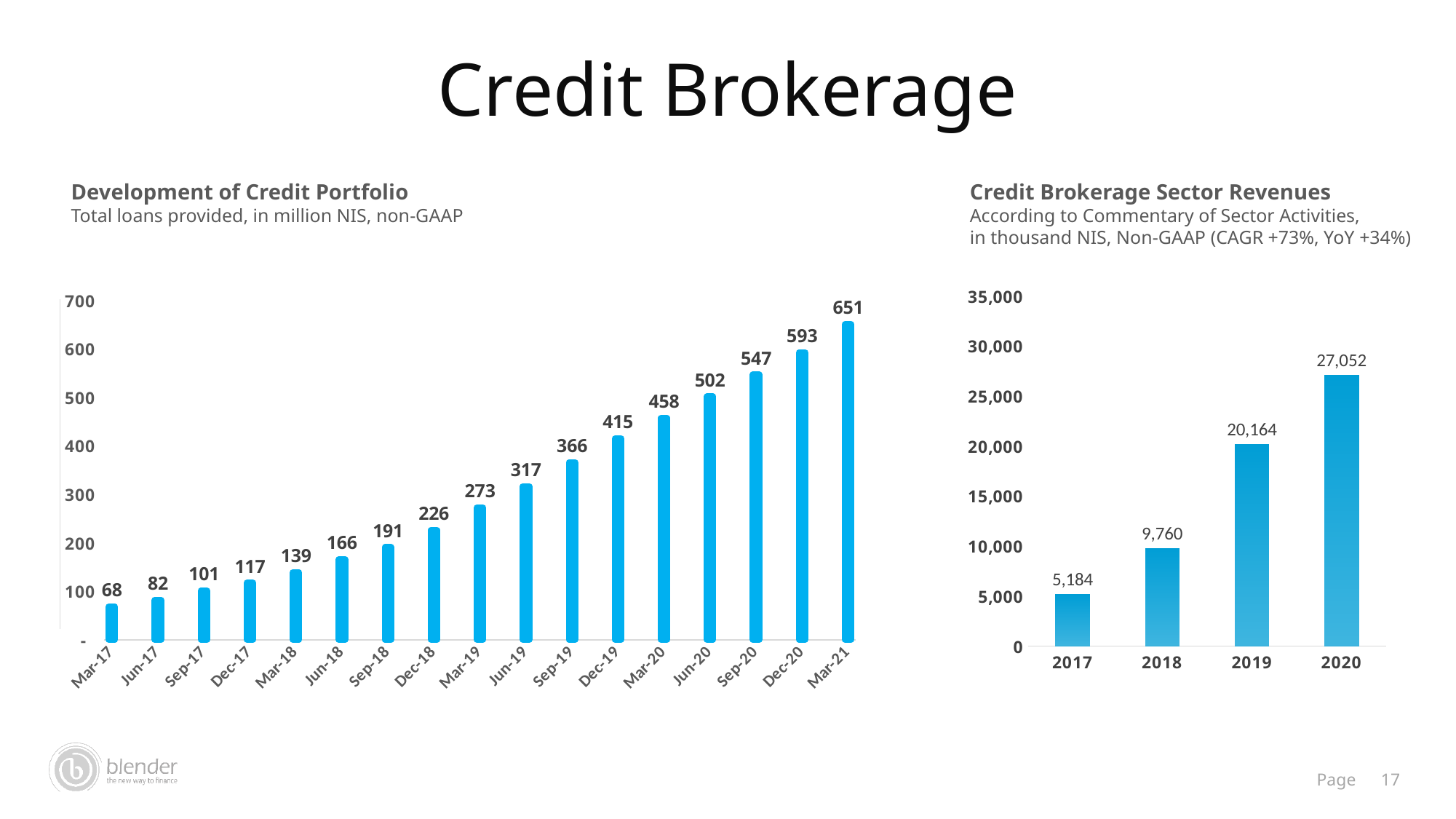
In the 'Development of Credit Portfolio' chart, what is the value for Mar-21? 651 In the 'Credit Brokerage Sector Revenues' chart, which is larger, the value for 2019 or the value for 2018? 2019 In the 'Credit Brokerage Sector Revenues' chart, which year has the highest value? 2020 In the 'Development of Credit Portfolio' chart, what is the value for Dec-18? 226 What kind of chart is the 'Credit Brokerage Sector Revenues' chart? bar chart In the 'Development of Credit Portfolio' chart, which quarter has the lowest value? Mar-17 In the 'Development of Credit Portfolio' chart, how many quarters are plotted? 17 In the 'Development of Credit Portfolio' chart, do the values rise or fall from Mar-17 to Mar-21? rise In the 'Development of Credit Portfolio' chart, what is the difference between the Mar-21 and Mar-20 values? 193 In the 'Credit Brokerage Sector Revenues' chart, what is the value for 2019? 20,164 What unit is stated in the subtitle of the 'Development of Credit Portfolio' chart? million NIS In the 'Credit Brokerage Sector Revenues' chart, what is the difference between the 2018 and 2017 values? 4,576